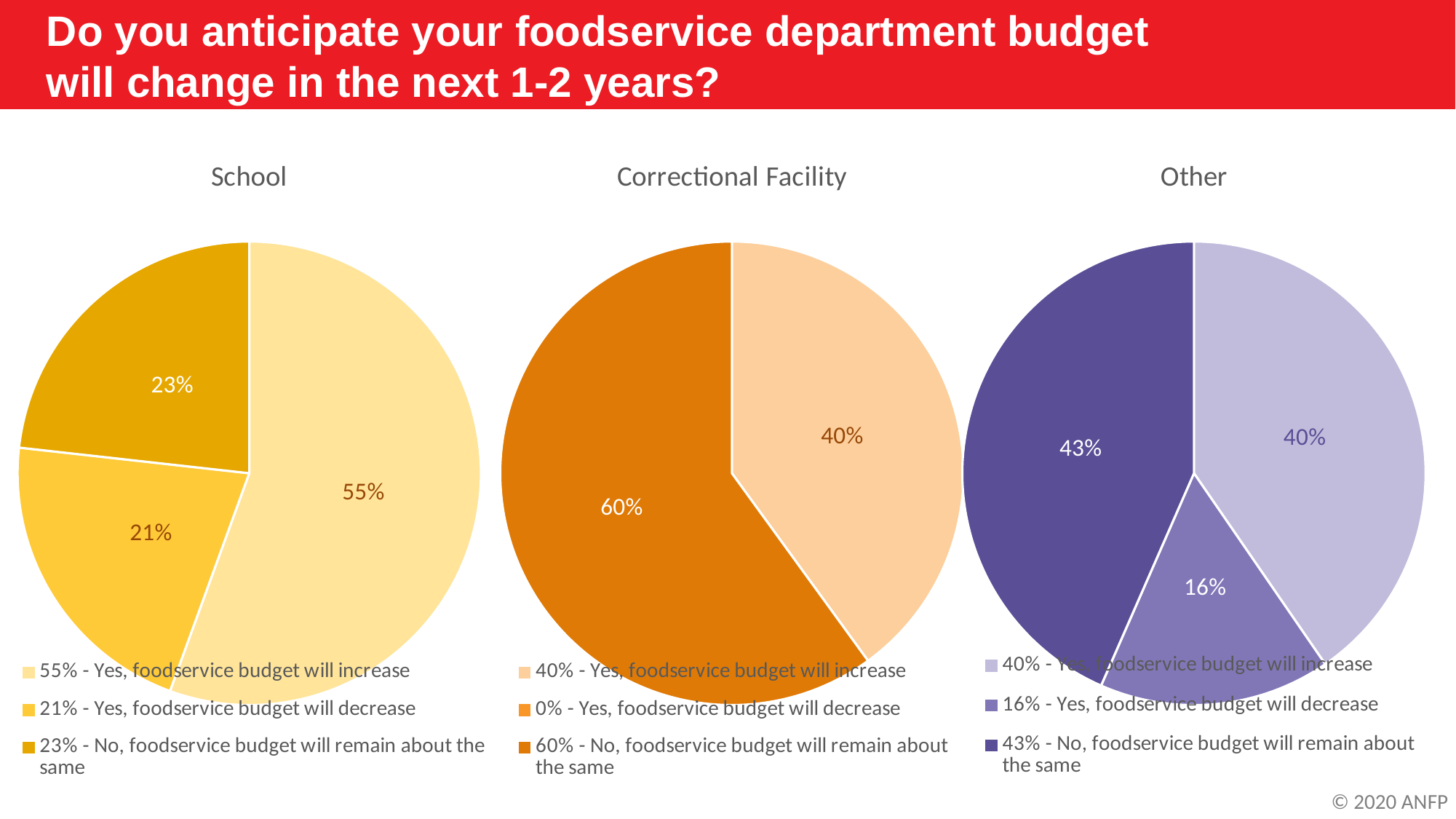
In the School pie chart, which response has the largest share? Yes, foodservice budget will increase What kind of chart is used for the School data? Pie chart In the Correctional Facility pie chart, what share of respondents said the foodservice budget will decrease? 0% In the School pie chart, what share of respondents said the foodservice budget will increase? 55% In the School pie chart, which is larger: the share saying the budget will decrease or the share saying it will remain about the same? No, foodservice budget will remain about the same In the Other pie chart, which response has the smallest share? Yes, foodservice budget will decrease In the Correctional Facility pie chart, what share of respondents said the foodservice budget will remain about the same? 60% In the Other pie chart, what share of respondents said the foodservice budget will decrease? 16% How many entries does the legend of the Correctional Facility chart list? 3 How many pie charts are shown on the slide? 3 What is the title of the chart on the right of the slide? Other In the Other pie chart, what is the difference between the share saying the budget will remain about the same and the share saying it will increase? 3%